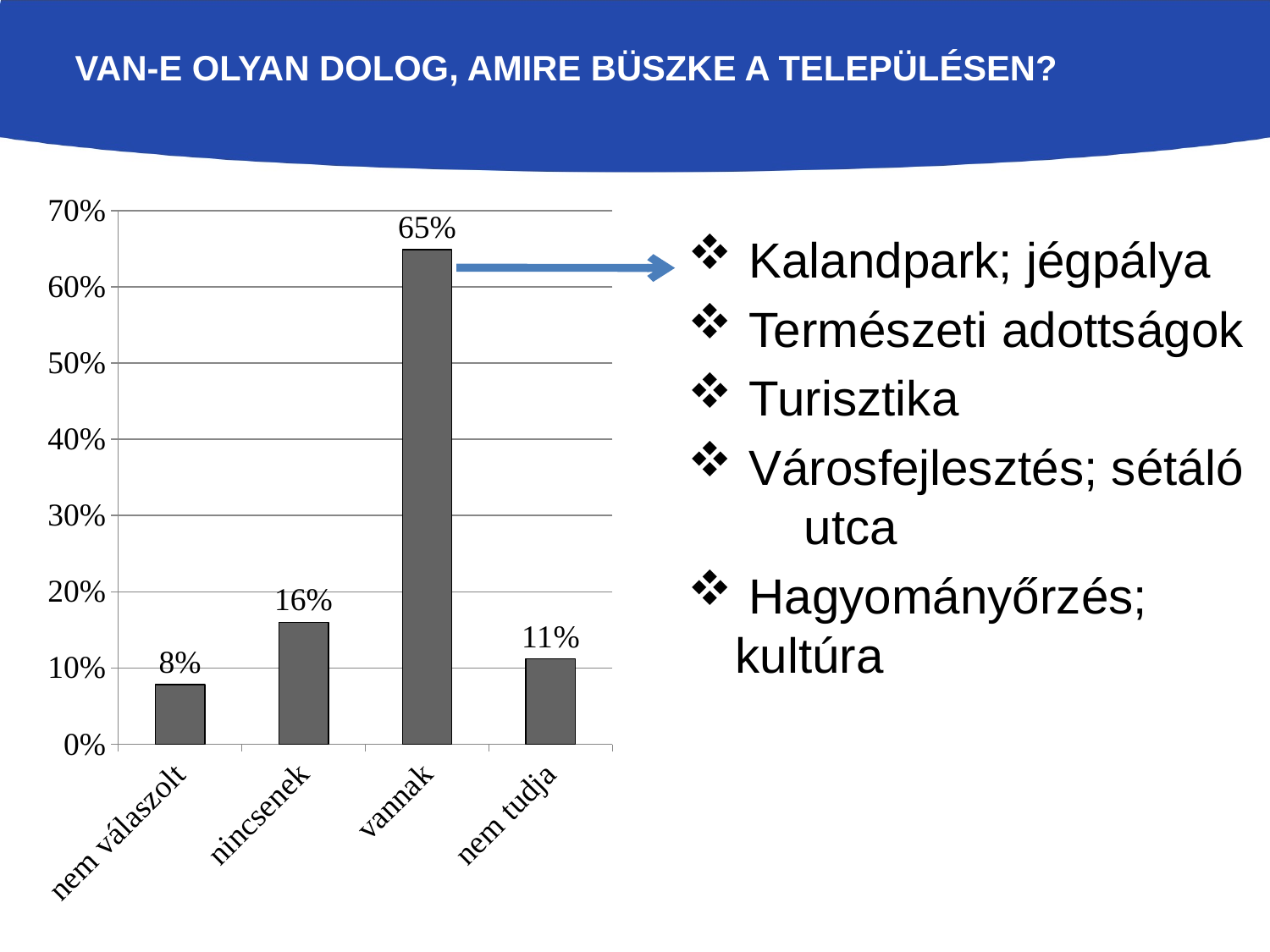
Which is larger, the value for "nincsenek" or the value for "nem tudja"? nincsenek Is the value for "vannak" greater or less than 60%? greater What is the title of the slide above the chart? VAN-E OLYAN DOLOG, AMIRE BÜSZKE A TELEPÜLÉSEN? Which category has the lowest value? nem válaszolt What is the value for "vannak"? 65% What is the value for "nem tudja"? 11% How many categories are shown on the x axis? 4 What kind of chart is shown on the slide? bar chart Which category has the highest value? vannak What is the value for "nem válaszolt"? 8% What is the difference between the values for "vannak" and "nincsenek"? 49% What is the value for "nincsenek"? 16%